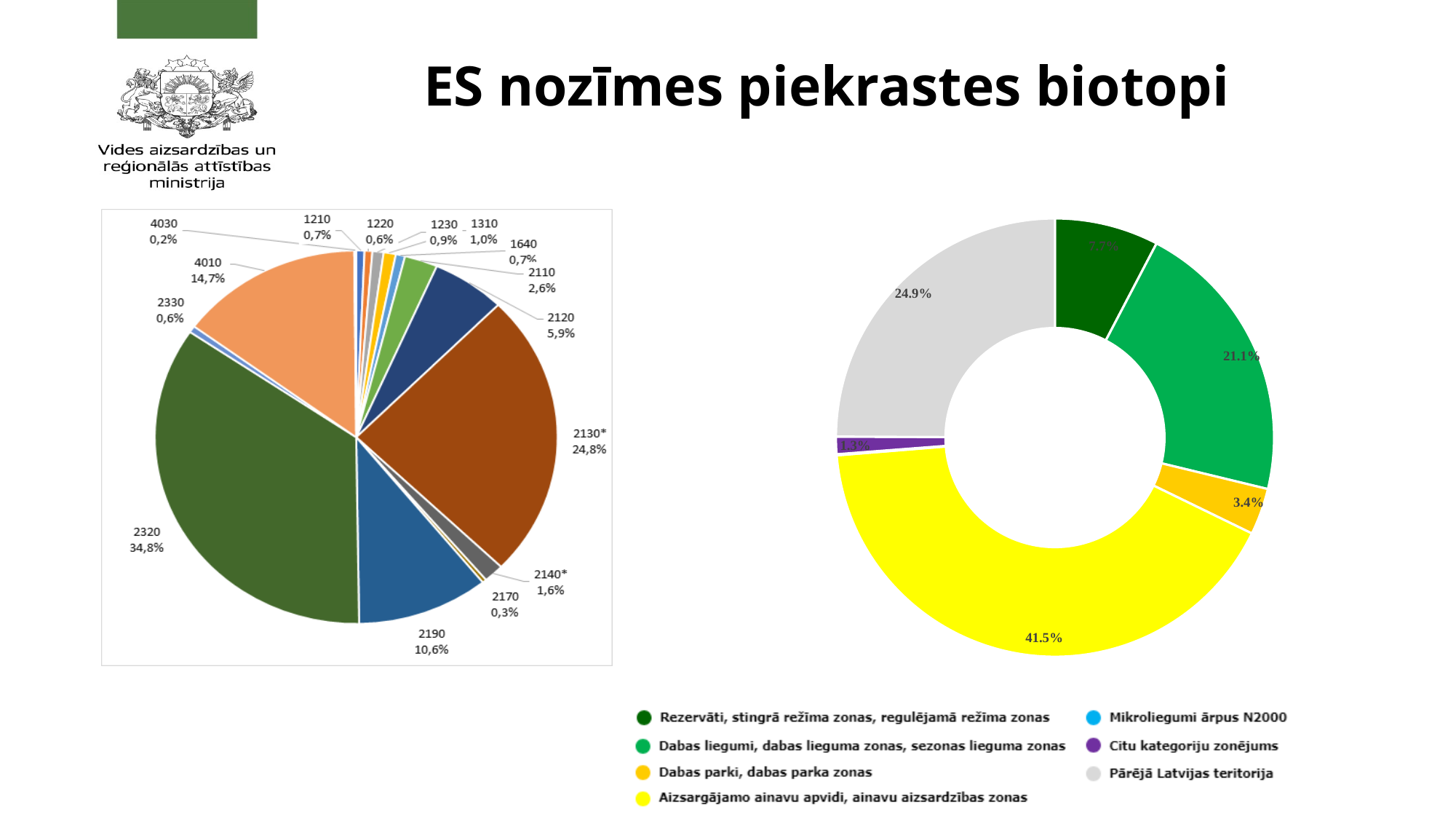
In the right donut chart, what percentage is shown for Pārējā Latvijas teritorija? 24.9% In the left pie chart, which habitat code has the smallest share? 4030 In the left pie chart, which has a larger share, 2110 or 2140*? 2110 In the left pie chart, what percentage is shown for habitat 4010? 14,7% In the left pie chart, what percentage is shown for habitat 2320? 34,8% How many slices are labelled in the left pie chart? 15 In the left pie chart, which habitat code has the largest share? 2320 In the right donut chart, which category has the largest share? Aizsargājamo ainavu apvidi, ainavu aizsardzības zonas In the left pie chart, what is the difference between the shares of 2190 and 2120? 4,7% How many entries does the legend of the right donut chart list? 7 In the right donut chart, what percentage is shown for the yellow segment (Aizsargājamo ainavu apvidi, ainavu aizsardzības zonas)? 41.5% In the left pie chart, what percentage is shown for habitat 2130*? 24,8%